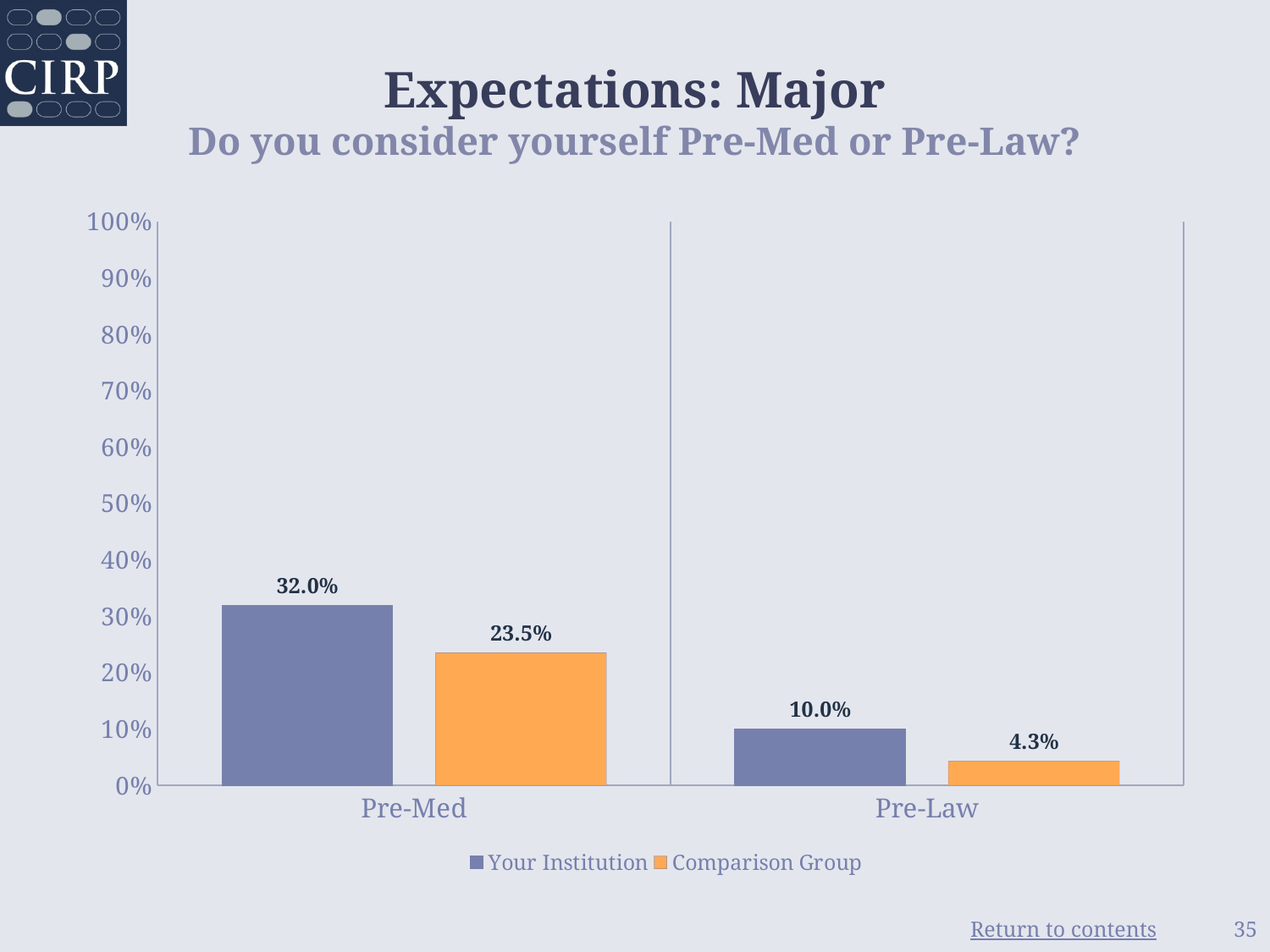
What is the value for Your Institution in the Pre-Med category? 32.0% What is the difference between Your Institution and Comparison Group in the Pre-Med category? 8.5% What is the value for Comparison Group in the Pre-Med category? 23.5% What is the value for Comparison Group in the Pre-Law category? 4.3% What is the difference between Your Institution and Comparison Group in the Pre-Law category? 5.7% What is the value for Your Institution in the Pre-Law category? 10.0% How many categories are shown on the x axis? 2 How many series does the legend list? 2 What kind of chart is shown on the slide? Bar chart Which category has the lowest value for Comparison Group? Pre-Law Which category has the highest value for Your Institution? Pre-Med Which is larger in the Pre-Law category: Your Institution or Comparison Group? Your Institution